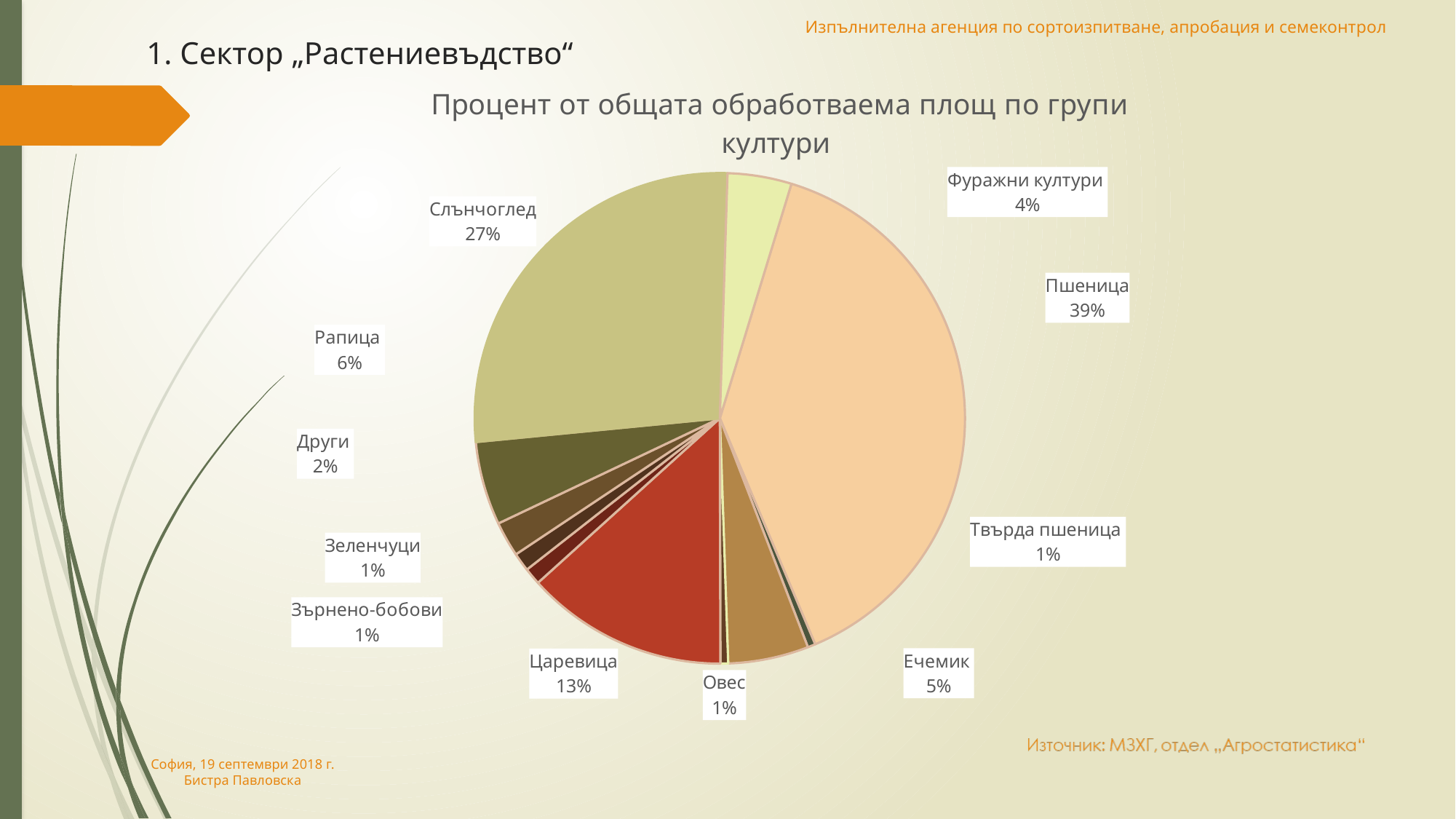
What is the combined share of Царевица and Ечемик? 18% What is the difference between the shares of Пшеница and Слънчоглед? 12% What is the title of the chart? Процент от общата обработваема площ по групи култури How many crop groups (slices) are labelled in the pie chart? 11 What percentage of the total cultivated area is Пшеница? 39% Which crop group has the largest share of the cultivated area? Пшеница What is the value shown for Царевица? 13% What type of chart is shown on the slide? pie chart What is the value shown for Други? 2% What share does Слънчоглед have in the pie chart? 27% What is the value shown for Рапица? 6% Which has a larger share, Ечемик or Фуражни култури? Ечемик